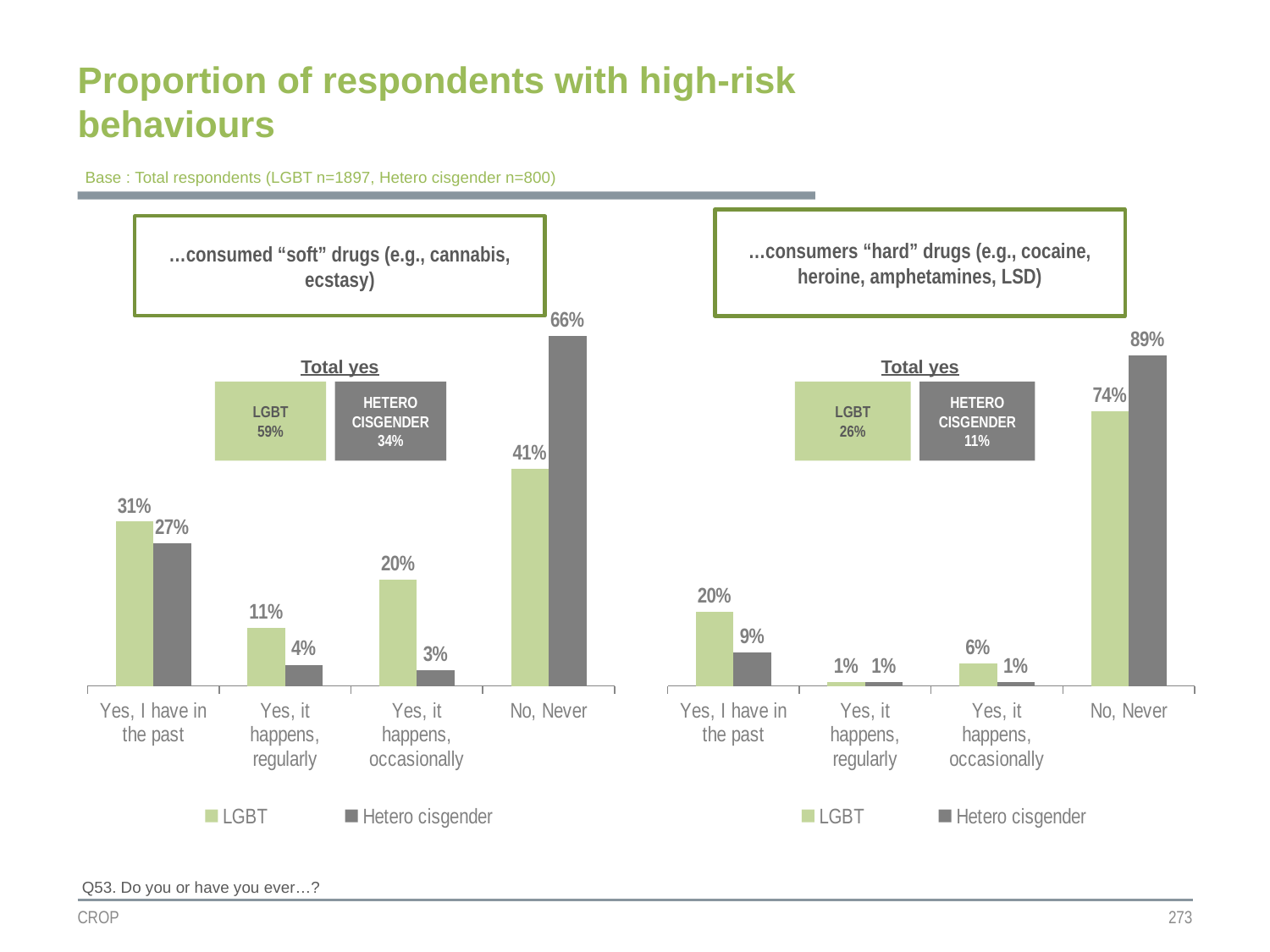
In the hard drugs chart, what percentage of Hetero cisgender respondents answered "No, Never"? 89% How many categories are shown on the x axis of the soft drugs chart? 4 In the hard drugs chart, what is the "Total yes" value shown for LGBT respondents? 26% In the soft drugs chart, what is the difference between the LGBT and Hetero cisgender values for "Yes, it happens, occasionally"? 17% In the soft drugs chart, what percentage of Hetero cisgender respondents answered "No, Never"? 66% What type of chart is used for the soft drugs data? Bar chart In the soft drugs chart, which category has the highest value for LGBT respondents? No, Never In the soft drugs chart, what percentage of LGBT respondents answered "Yes, I have in the past"? 31% In the hard drugs chart, which group has the larger value for "Yes, I have in the past", LGBT or Hetero cisgender? LGBT How many series does the legend of the hard drugs chart list? 2 In the hard drugs chart, what percentage of LGBT respondents answered "Yes, I have in the past"? 20%